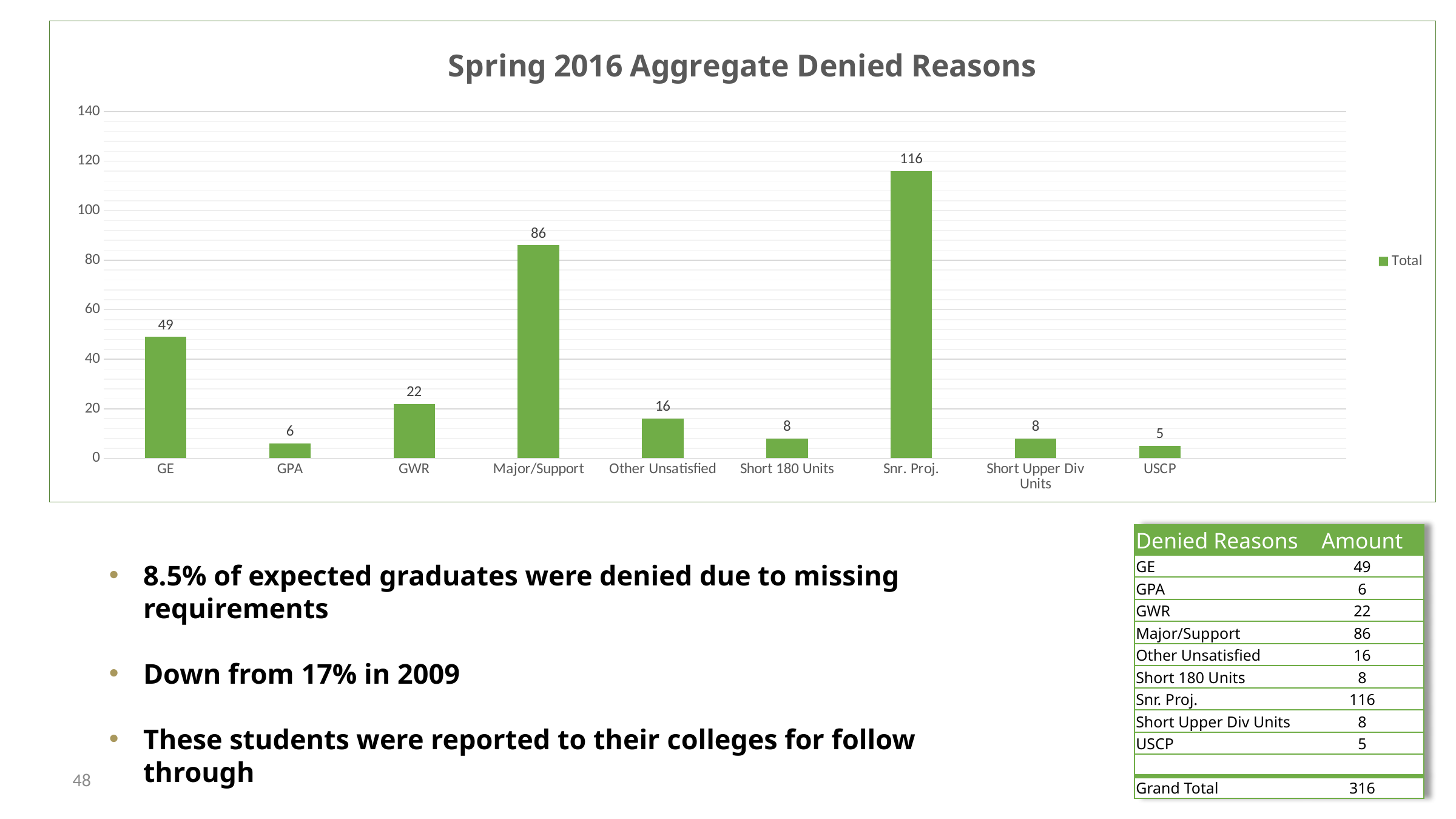
Which category has the highest value in the chart? Snr. Proj. Is the value for Snr. Proj. greater or less than 100? greater Which category has the lowest value in the chart? USCP What is the difference between the values for Snr. Proj. and Major/Support? 30 What is the difference between the values for GE and GWR? 27 How many categories are shown on the x axis of the chart? 9 What is the value for Snr. Proj. in the Spring 2016 Aggregate Denied Reasons chart? 116 What is the value for Major/Support in the chart? 86 What kind of chart is shown on the slide? bar chart How many series does the chart legend list? 1 What is the value for Other Unsatisfied in the chart? 16 Which is larger, the value for GE or the value for GWR? GE